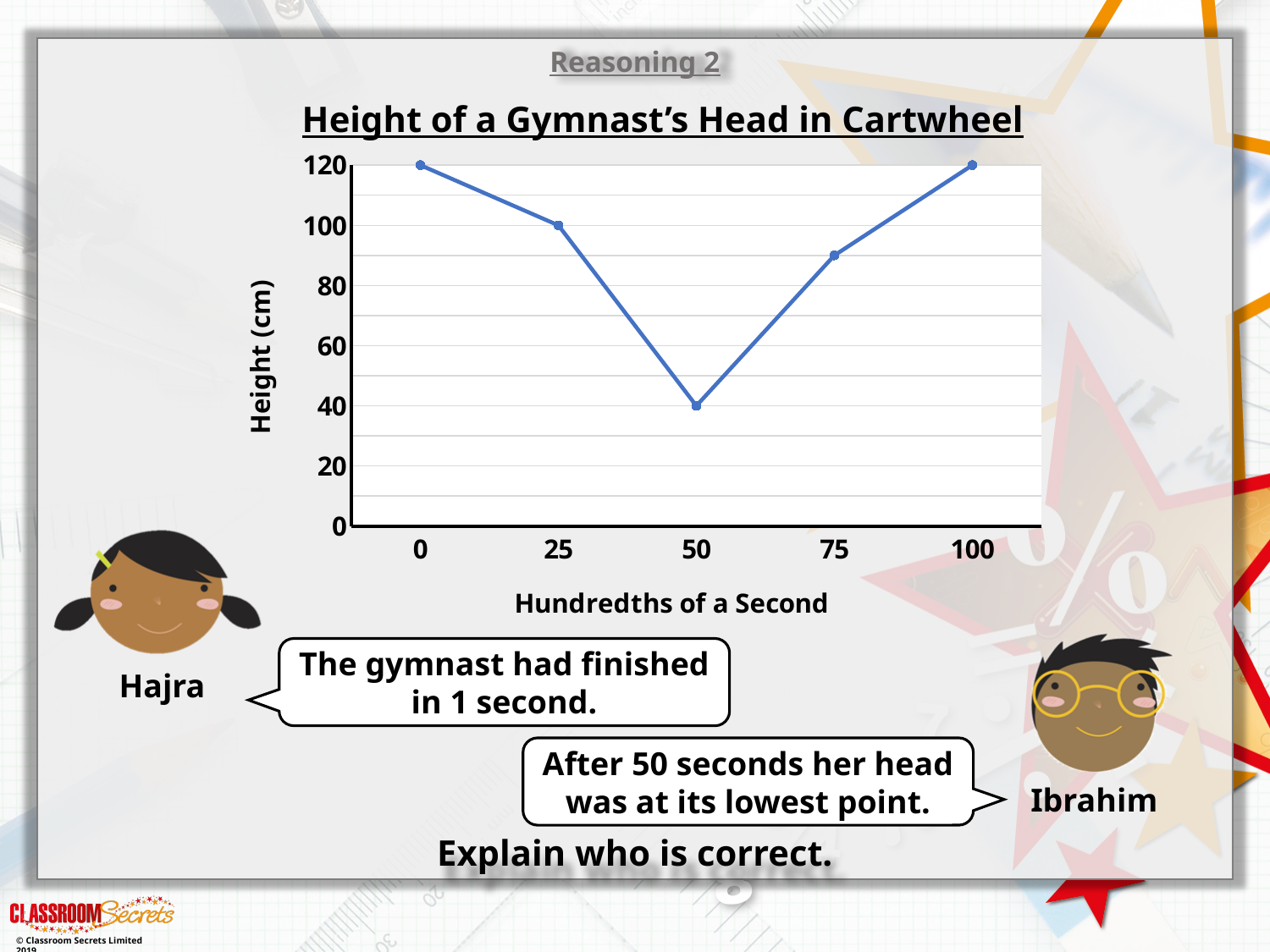
Is the height at 75 hundredths of a second greater or less than 80? greater How many data points are plotted on the line? 5 At which time (in hundredths of a second) is the height lowest? 50 What is the label on the vertical axis? Height (cm) What is the height at 25 hundredths of a second? 100 cm What is the height at 50 hundredths of a second? 40 cm What is the height at 0 hundredths of a second? 120 cm What is the height at 100 hundredths of a second? 120 cm What kind of chart is shown? Line chart What is the difference in height between 0 and 50 hundredths of a second? 80 cm Which is higher, the height at 25 or at 50 hundredths of a second? 25 Does the height rise or fall between 0 and 50 hundredths of a second? Fall